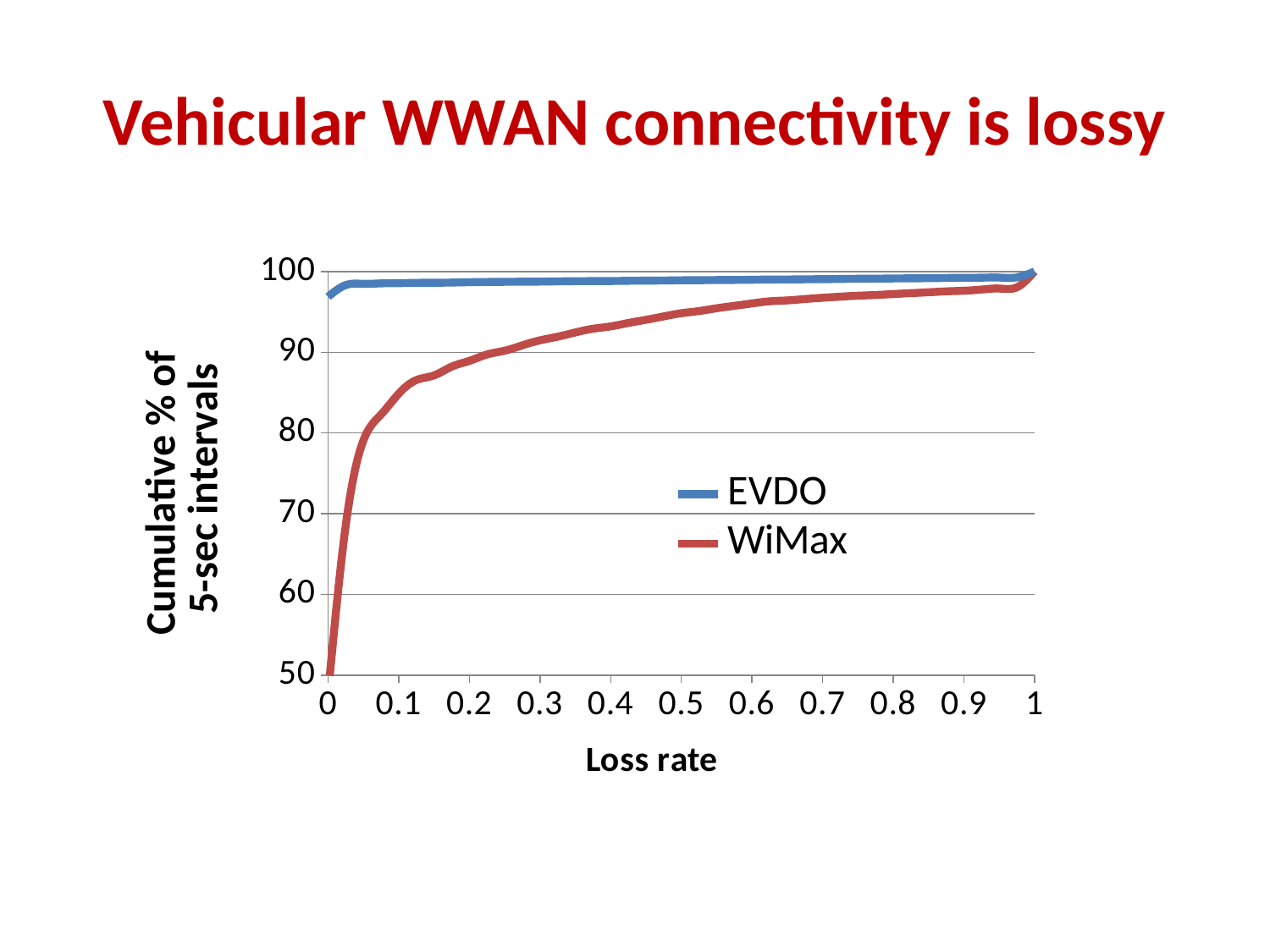
What is the label of the x axis? Loss rate Is the value for WiMax at a loss rate of 0.1 greater or less than 90? less Is the value for WiMax at a loss rate of 0.5 greater or less than 90? greater What kind of chart is shown on the slide? line chart Which series lies higher across the whole range of loss rates? EVDO Do the WiMax values rise or fall as the loss rate increases? rise Which series lies lower across the whole range of loss rates? WiMax What are the two series named in the legend? EVDO and WiMax How many series does the legend list? 2 Is the value for EVDO at a loss rate of 0.5 greater or less than 90? greater Which series has the higher cumulative % at a loss rate of 0.1, EVDO or WiMax? EVDO